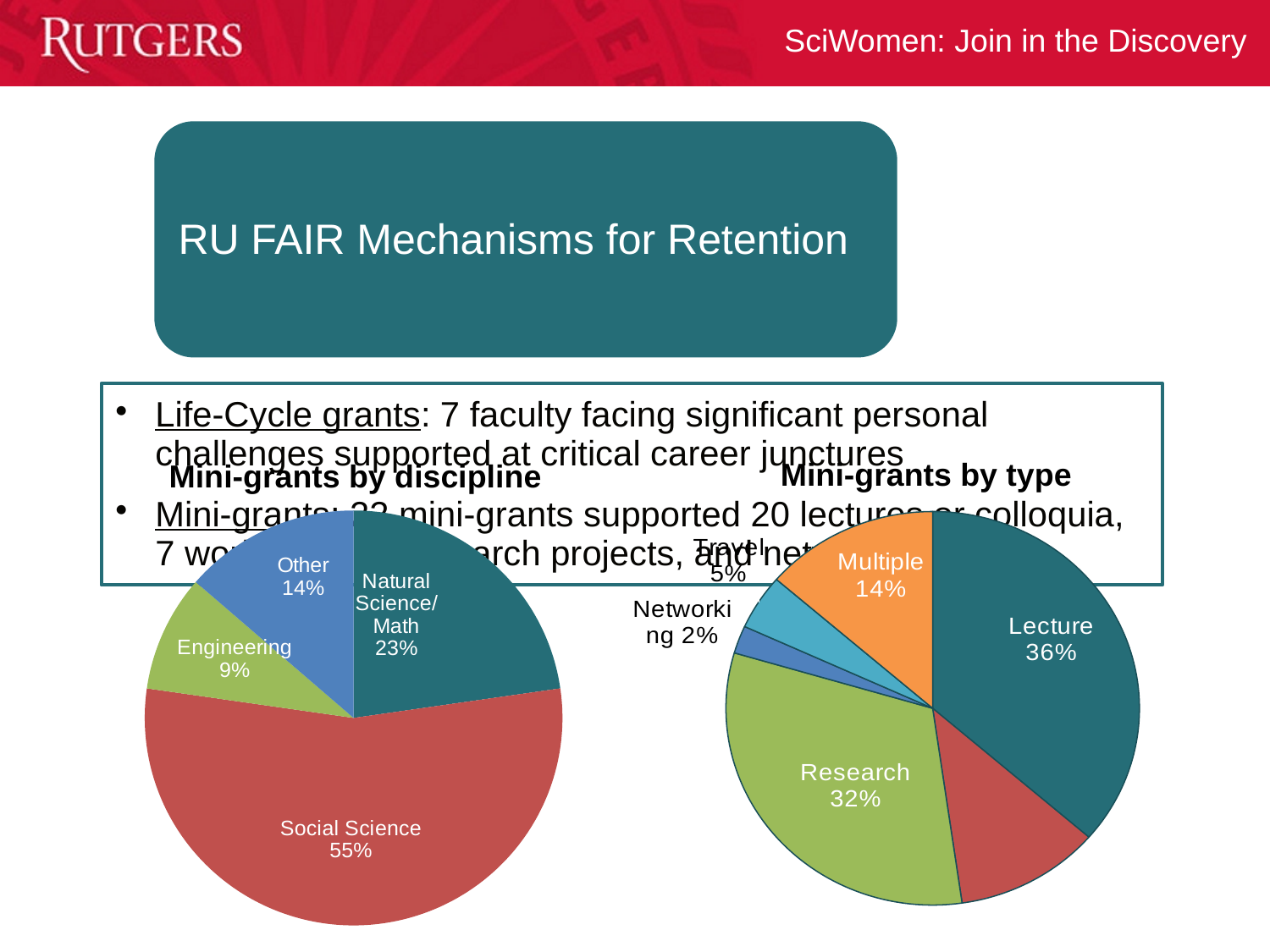
In the 'Mini-grants by discipline' chart, which discipline has the largest share? Social Science In the 'Mini-grants by discipline' chart, what share of mini-grants went to Social Science? 55% In the 'Mini-grants by type' chart, how many percentage points larger is Lecture than Research? 4 percentage points In the 'Mini-grants by type' chart, which labeled type has the smallest share? Networking In the 'Mini-grants by type' chart, what share of mini-grants is Research? 32% In the 'Mini-grants by type' chart, which is larger: Multiple or Travel? Multiple How many slices does the 'Mini-grants by discipline' pie chart have? 4 In the 'Mini-grants by discipline' chart, which discipline has the smallest share? Engineering What is the title of the pie chart on the right side of the slide? Mini-grants by type In the 'Mini-grants by discipline' chart, how many percentage points larger is the Natural Science/Math share than the Other share? 9 percentage points In the 'Mini-grants by type' chart, what share of mini-grants is Lecture? 36% What kind of chart is the 'Mini-grants by discipline' chart? Pie chart